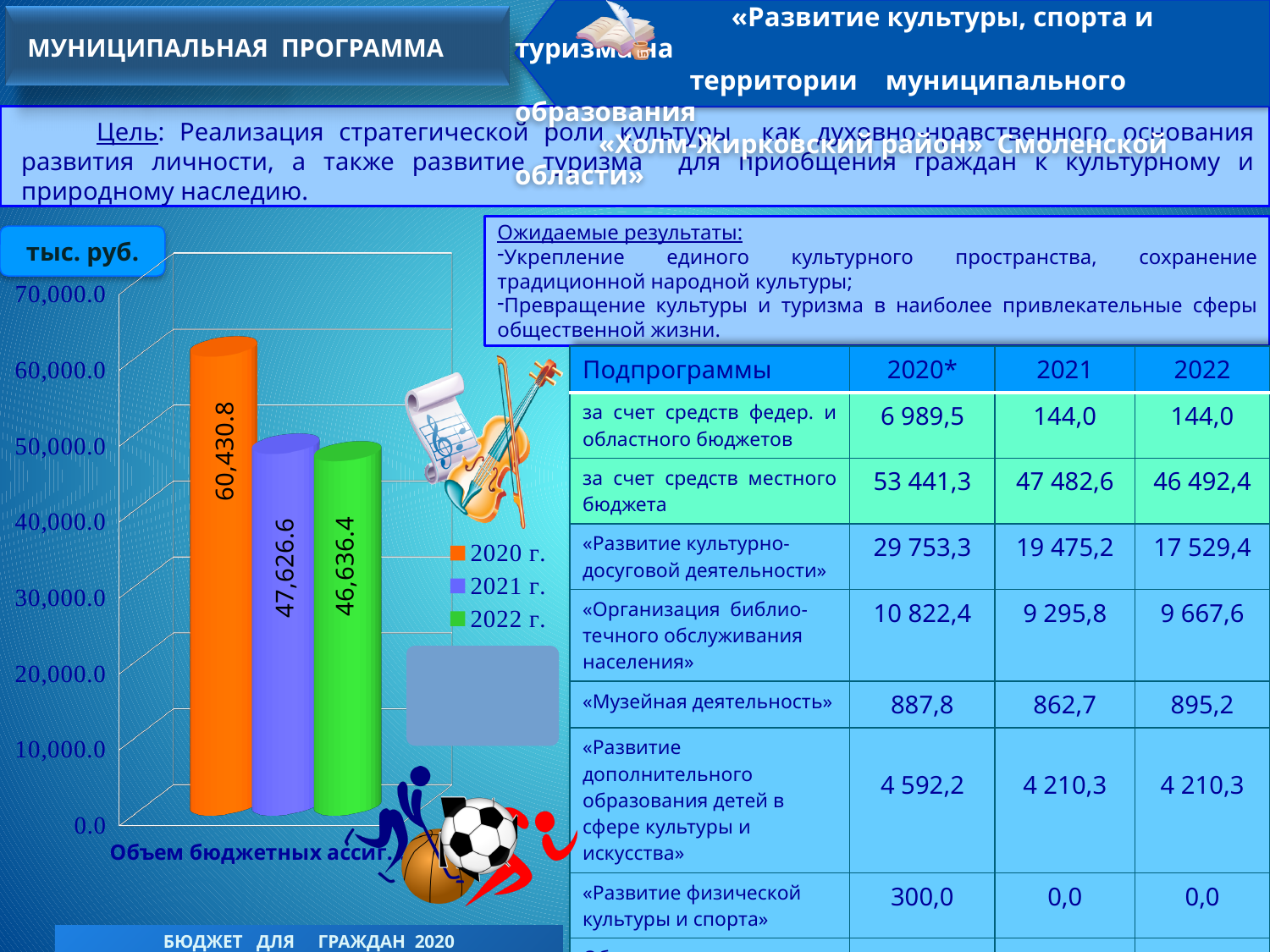
Which is larger in the chart, the value for 2020 г. or the value for 2022 г.? 2020 г. What is the value of the 2021 г. bar in the chart? 47,626.6 Which year has the highest bar in the chart? 2020 г. What unit is shown in the label above the chart's vertical axis? тыс. руб. What is the value of the 2020 г. bar in the chart? 60,430.8 What is the value of the 2022 г. bar in the chart? 46,636.4 What is the difference between the 2020 г. and 2021 г. values in the chart? 12,804.2 What kind of chart is shown on the slide? bar chart Is the value for 2021 г. in the chart greater or less than 50,000.0? less How many series does the chart legend list? 3 Which year has the lowest bar in the chart? 2022 г. What is the difference between the 2021 г. and 2022 г. values in the chart? 990.2